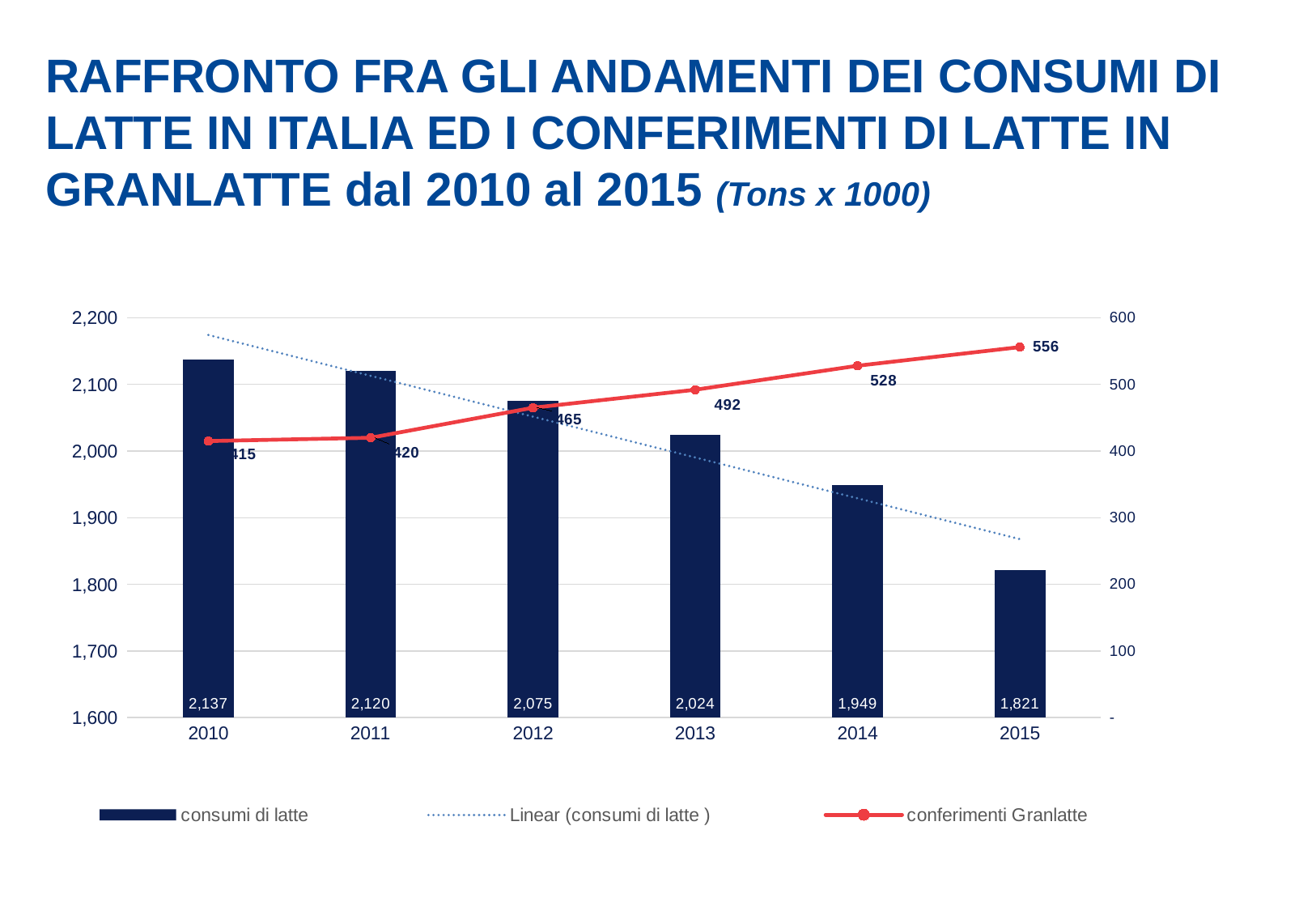
What colour is the conferimenti Granlatte line? red What is the value of conferimenti Granlatte for 2015? 556 What is the value of conferimenti Granlatte for 2012? 465 Do the values for conferimenti Granlatte rise or fall from 2010 to 2015? rise Which year has the highest value for conferimenti Granlatte? 2015 How many series does the legend list? 3 How many years are shown on the x axis? 6 What is the difference between consumi di latte in 2010 and in 2015? 316 What is the value of consumi di latte for 2010? 2,137 Which is larger, consumi di latte in 2013 or in 2014? 2013 What is the difference between conferimenti Granlatte in 2014 and in 2013? 36 Which year has the lowest value for consumi di latte? 2015